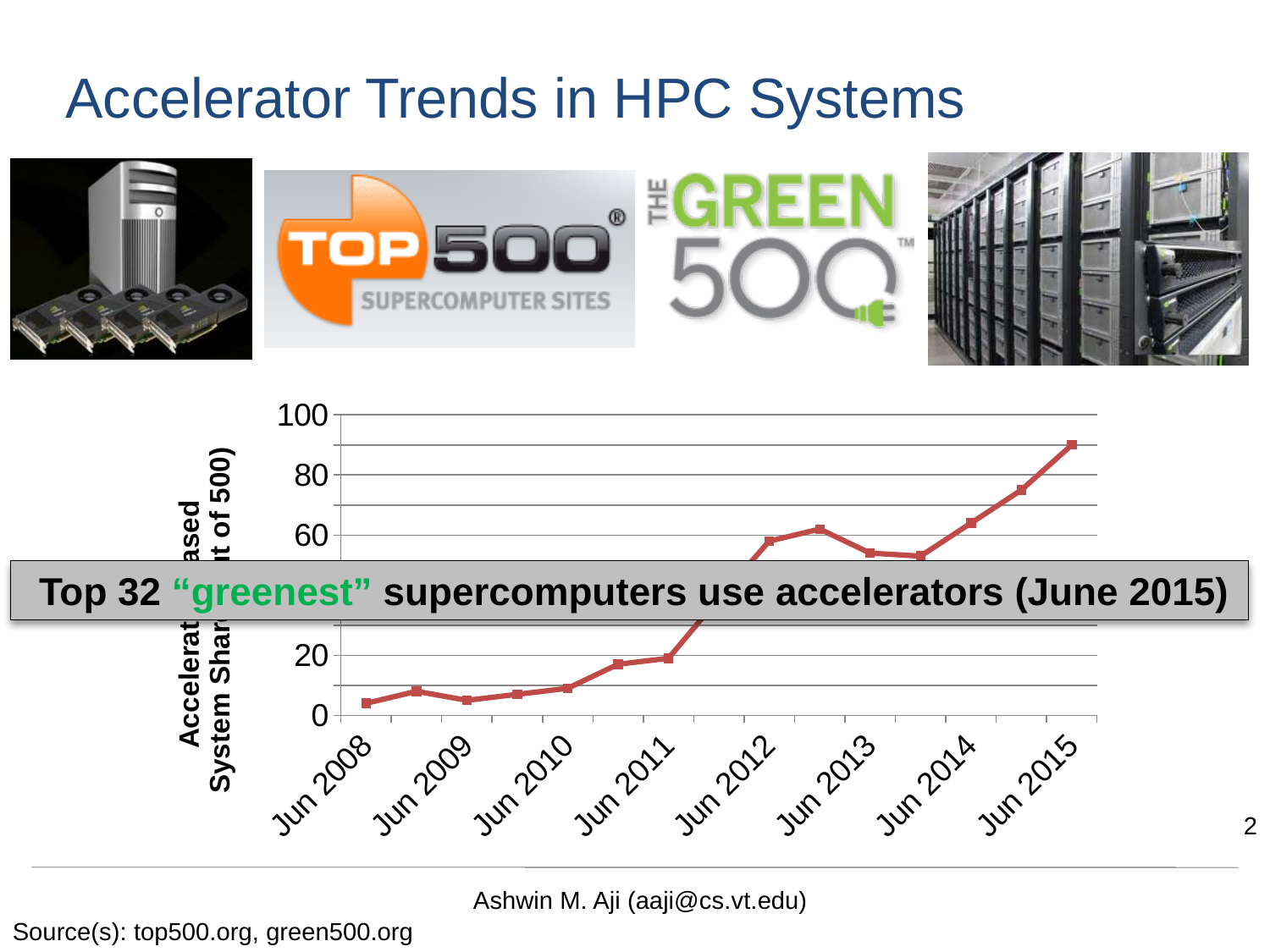
Is the value for Jun 2015 greater or less than 80? greater Is the value for Jun 2008 greater or less than 20? less Which labeled year on the x axis has the highest value? Jun 2015 Is the value for Jun 2014 greater or less than 60? greater What kind of chart is shown on the slide? line chart Which is larger, the value for Jun 2015 or the value for Jun 2008? Jun 2015 How many year labels are shown on the x axis? 8 Which is larger, the value for Jun 2014 or the value for Jun 2011? Jun 2014 What colour is the plotted line? red Overall, do the values rise or fall from Jun 2008 to Jun 2015? rise